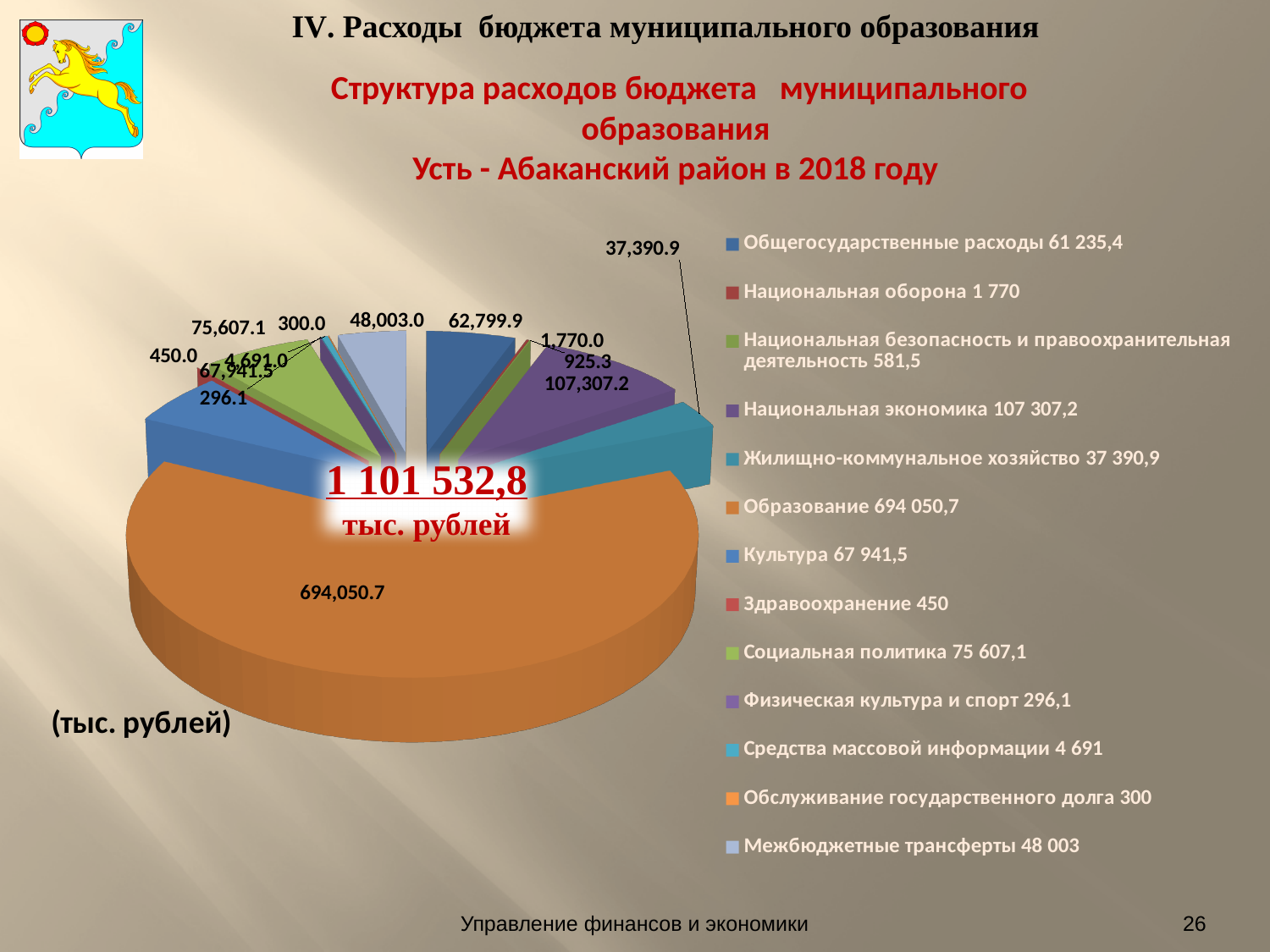
What kind of chart is shown on the slide? pie chart What is the difference between Социальная политика and Культура? 7 665,6 What is the value for Межбюджетные трансферты? 48 003 Which is larger, Культура or Социальная политика? Социальная политика What is the value for Жилищно-коммунальное хозяйство? 37 390,9 What is the value for Национальная экономика? 107 307,2 Which category has the largest slice of the pie? Образование What total amount is printed in the centre of the pie chart? 1 101 532,8 тыс. рублей Which category has the smallest value in the legend? Физическая культура и спорт What is the difference between Здравоохранение and Обслуживание государственного долга? 150 Which is larger, Национальная оборона or Средства массовой информации? Средства массовой информации How many expenditure categories does the legend list? 13